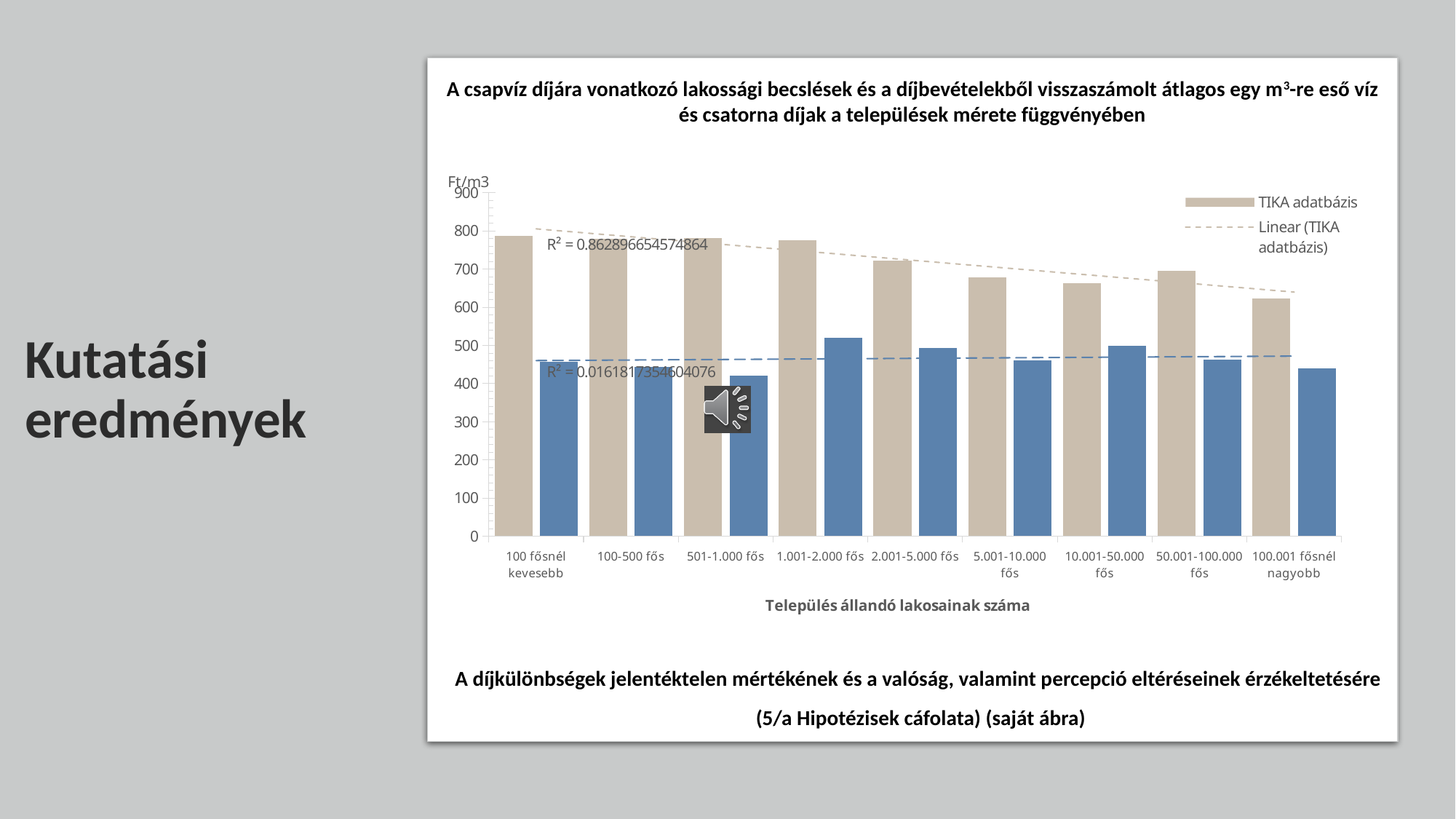
Is the blue bar for '501-1.000 fős' greater or less than 500? less Is the TIKA adatbázis value for '5.001-10.000 fős' greater or less than 700? less Do the TIKA adatbázis values generally rise or fall as settlement size increases along the x axis? fall Which category has the lowest value for the TIKA adatbázis series? 100.001 fősnél nagyobb What R² value is shown for the Linear (TIKA adatbázis) trendline? R² = 0.862896654574864 Is the TIKA adatbázis value for '100 fősnél kevesebb' greater or less than 700? greater How many entries does the legend list? 2 What kind of chart is shown on the slide? bar chart How many settlement-size categories are shown on the x axis? 9 For the category '2.001-5.000 fős', which is larger: the TIKA adatbázis bar or the blue bar? TIKA adatbázis bar What is the title of the x axis? Település állandó lakosainak száma